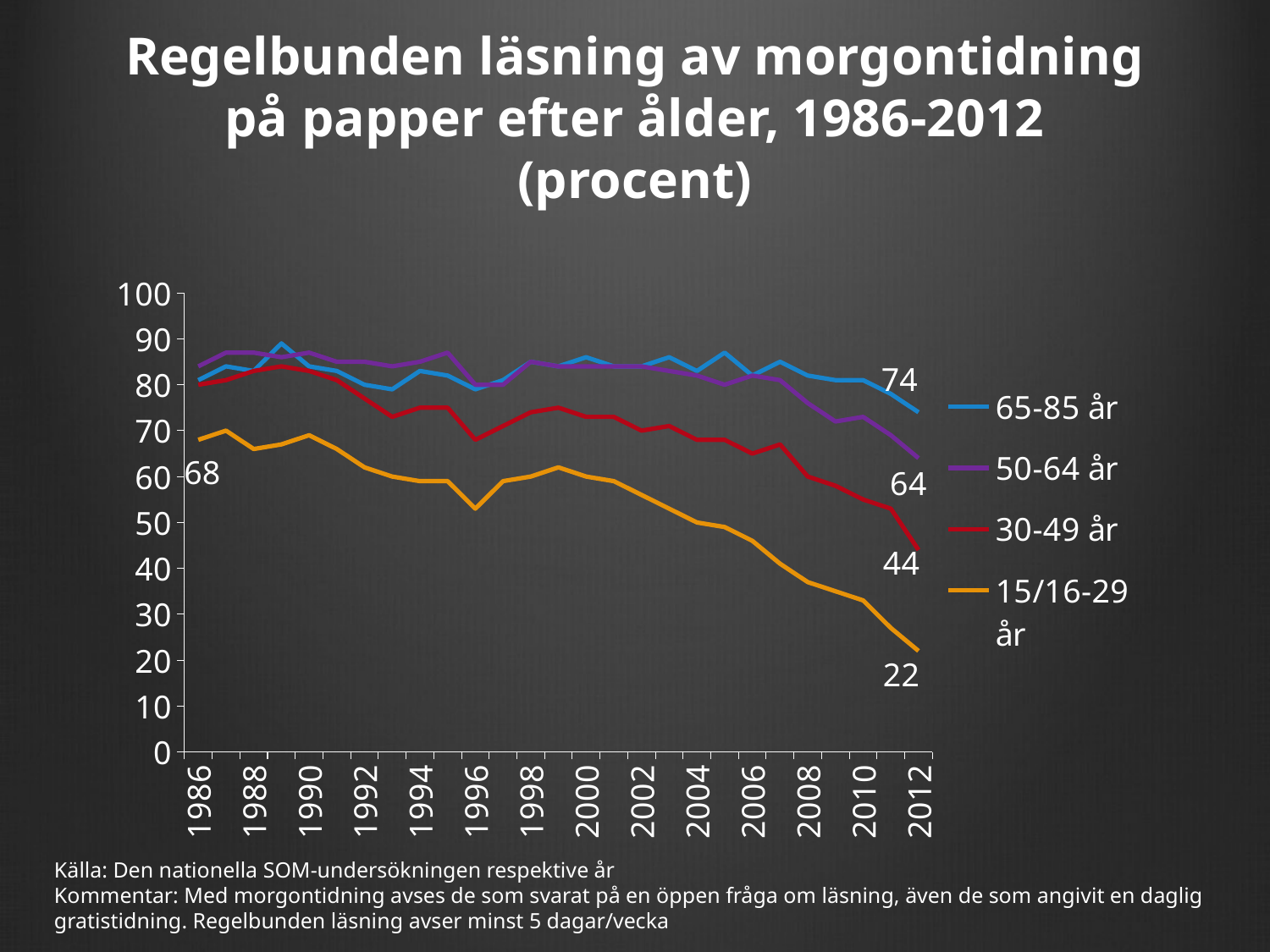
By how much did the value for 15/16-29 år fall from 1986 to 2012? 46 Which age group has the lowest value in 2012? 15/16-29 år What is the difference between the 2012 values for 65-85 år and 15/16-29 år? 52 Which age group has the highest value in 2012? 65-85 år What type of chart is shown on the slide? line chart Does the value for 15/16-29 år rise or fall from 1986 to 2012? fall What is the value for 15/16-29 år in 1986? 68 How many series does the legend list? 4 Is the value for 15/16-29 år in 2000 greater or less than 50? greater What is the value for 50-64 år in 2012? 64 What is the value for 30-49 år in 2012? 44 What is the value for 65-85 år in 2012? 74